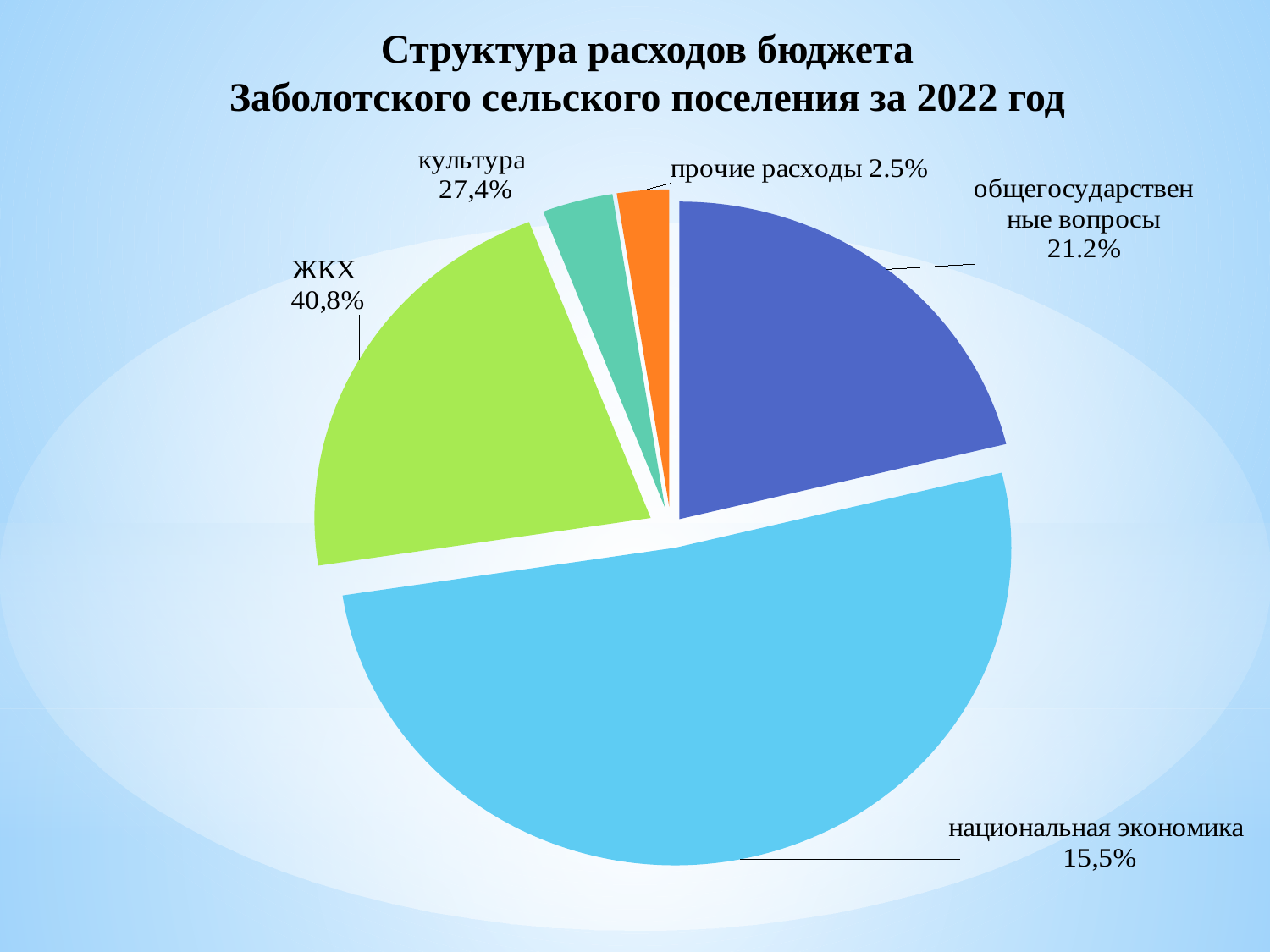
What percentage is labelled for национальная экономика? 15,5% What colour is the slice labelled прочие расходы? Orange How many categories are labelled on the pie chart? 5 What percentage is labelled for культура? 27,4% According to the labels, what is the difference between the shares of общегосударственные вопросы and прочие расходы? 18.7% What kind of chart is shown on the slide? Pie chart What is the title of the chart? Структура расходов бюджета Заболотского сельского поселения за 2022 год What percentage is labelled for общегосударственные вопросы? 21.2% What percentage is labelled for прочие расходы? 2.5% What percentage is labelled for ЖКХ? 40,8% According to the labels, what is the difference between the shares of ЖКХ and культура? 13,4% According to the labels, which has a larger share: культура or общегосударственные вопросы? культура